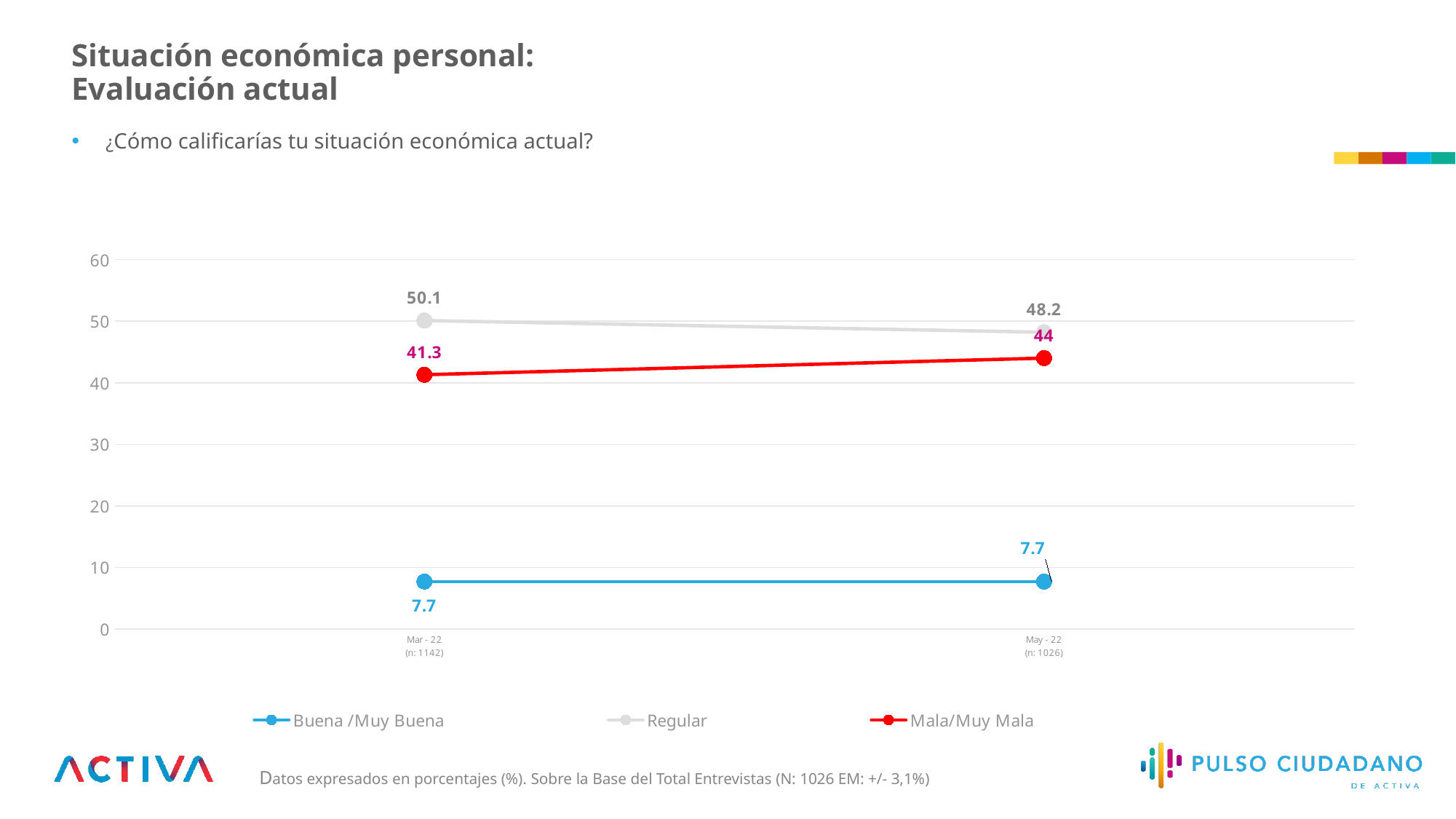
What is the value for Regular in May - 22? 48.2 What is the value for Buena /Muy Buena in Mar - 22? 7.7 Which is larger in May - 22: Regular or Mala/Muy Mala? Regular What is the value for Mala/Muy Mala in May - 22? 44 Does the Mala/Muy Mala series rise or fall from Mar - 22 to May - 22? rise What is the difference between the Regular and Mala/Muy Mala values in Mar - 22? 8.8 How many time points are shown on the x axis? 2 How many series does the legend list? 3 What is the value for Regular in Mar - 22? 50.1 Which series has the highest value in Mar - 22? Regular Which series has the lowest value in May - 22? Buena /Muy Buena What kind of chart is shown on the slide? line chart